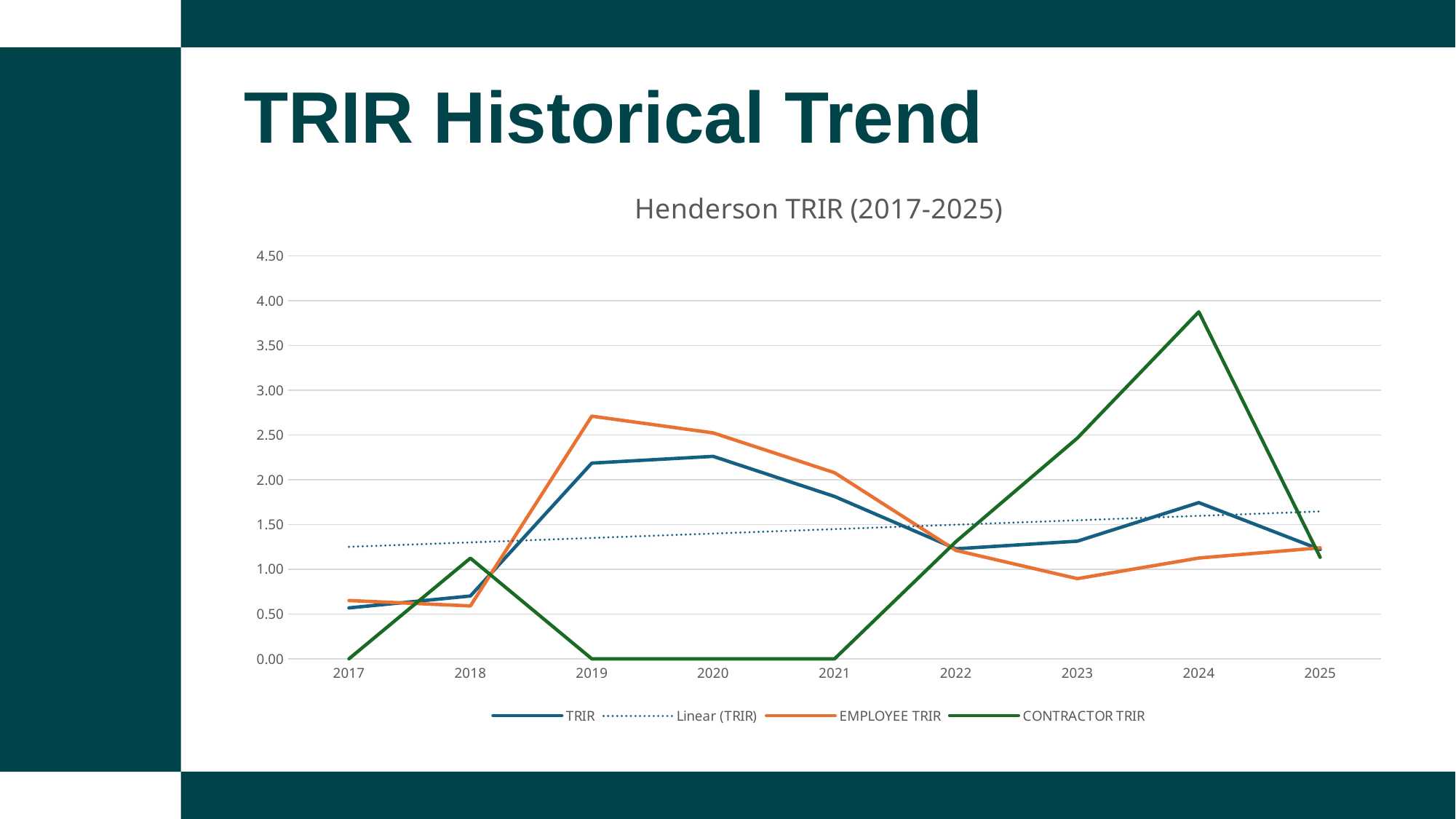
Is the TRIR value for 2017 greater or less than 1.00? less What kind of chart is shown on the slide? line chart Is the CONTRACTOR TRIR value for 2024 greater or less than 3.50? greater What is the CONTRACTOR TRIR value in 2020? 0.00 Does the Linear (TRIR) trend line rise or fall from 2017 to 2025? rise What is the CONTRACTOR TRIR value in 2017? 0.00 What is the title of the chart? Henderson TRIR (2017-2025) How many years are shown on the x axis? 9 Is the EMPLOYEE TRIR value for 2019 greater or less than 2.50? greater In which year does CONTRACTOR TRIR reach its highest value? 2024 In 2023, which is larger: TRIR or EMPLOYEE TRIR? TRIR How many series does the legend list? 4